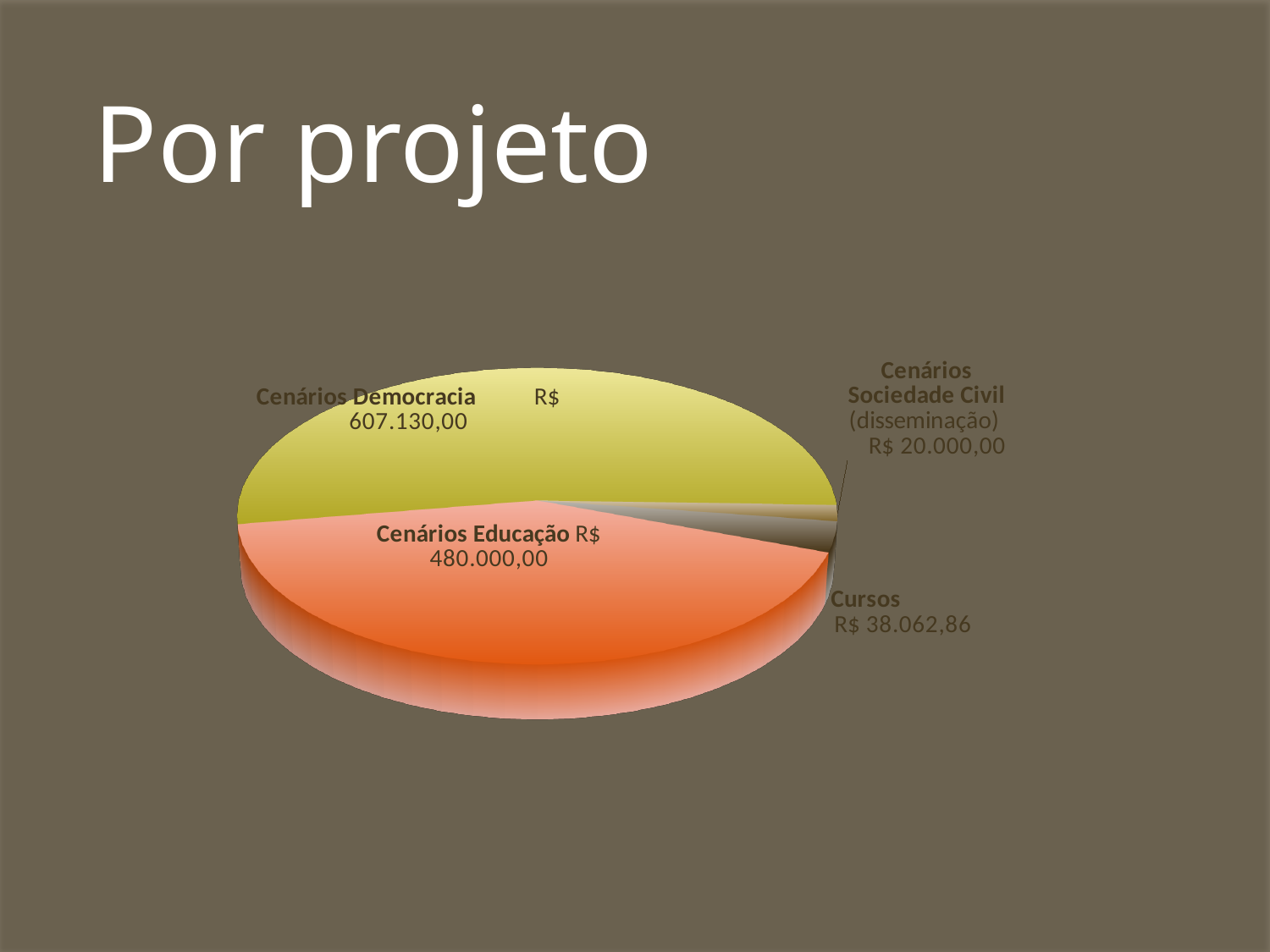
What is the value for Cenários Democracia? R$ 607.130,00 How many slices does the pie chart have? 4 Which project has the largest slice of the pie? Cenários Democracia What is the difference between the values for Cenários Democracia and Cenários Educação? R$ 127.130,00 What is the value for Cenários Educação? R$ 480.000,00 What is the title of the slide containing the pie chart? Por projeto What is the value for Cursos? R$ 38.062,86 What is the difference between the values for Cursos and Cenários Sociedade Civil (disseminação)? R$ 18.062,86 Which is larger, the value for Cursos or the value for Cenários Sociedade Civil (disseminação)? Cursos Which project has the smallest slice of the pie? Cenários Sociedade Civil (disseminação) What is the value for Cenários Sociedade Civil (disseminação)? R$ 20.000,00 What kind of chart is shown on the slide? Pie chart